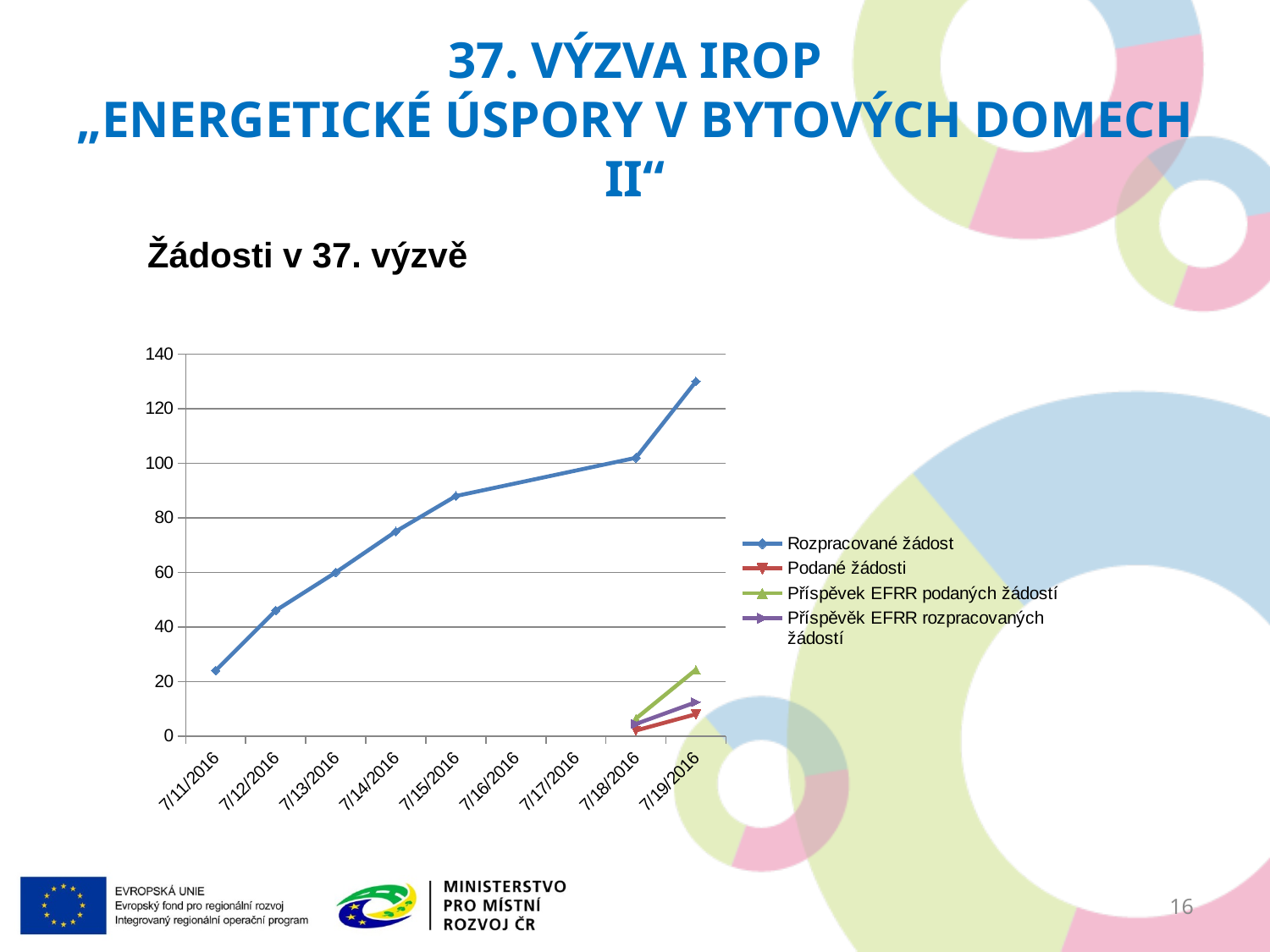
What is the title of the chart? Žádosti v 37. výzvě How many series does the legend of the chart list? 4 Is the value for Rozpracované žádost on 7/19/2016 greater or less than 120? greater On which date does the Rozpracované žádost series have its lowest value? 7/11/2016 What kind of chart is shown on the slide? line chart Is the value for Rozpracované žádost on 7/11/2016 greater or less than 40? less What colour is the line for Rozpracované žádost? blue Does the Rozpracované žádost series rise or fall from 7/11/2016 to 7/19/2016? rise How many dates are shown on the x axis of the chart? 9 On which date does the Rozpracované žádost series reach its highest value? 7/19/2016 Is the value for Rozpracované žádost on 7/15/2016 greater or less than 80? greater On 7/19/2016, which is larger: Příspěvek EFRR podaných žádostí or Podané žádosti? Příspěvek EFRR podaných žádostí